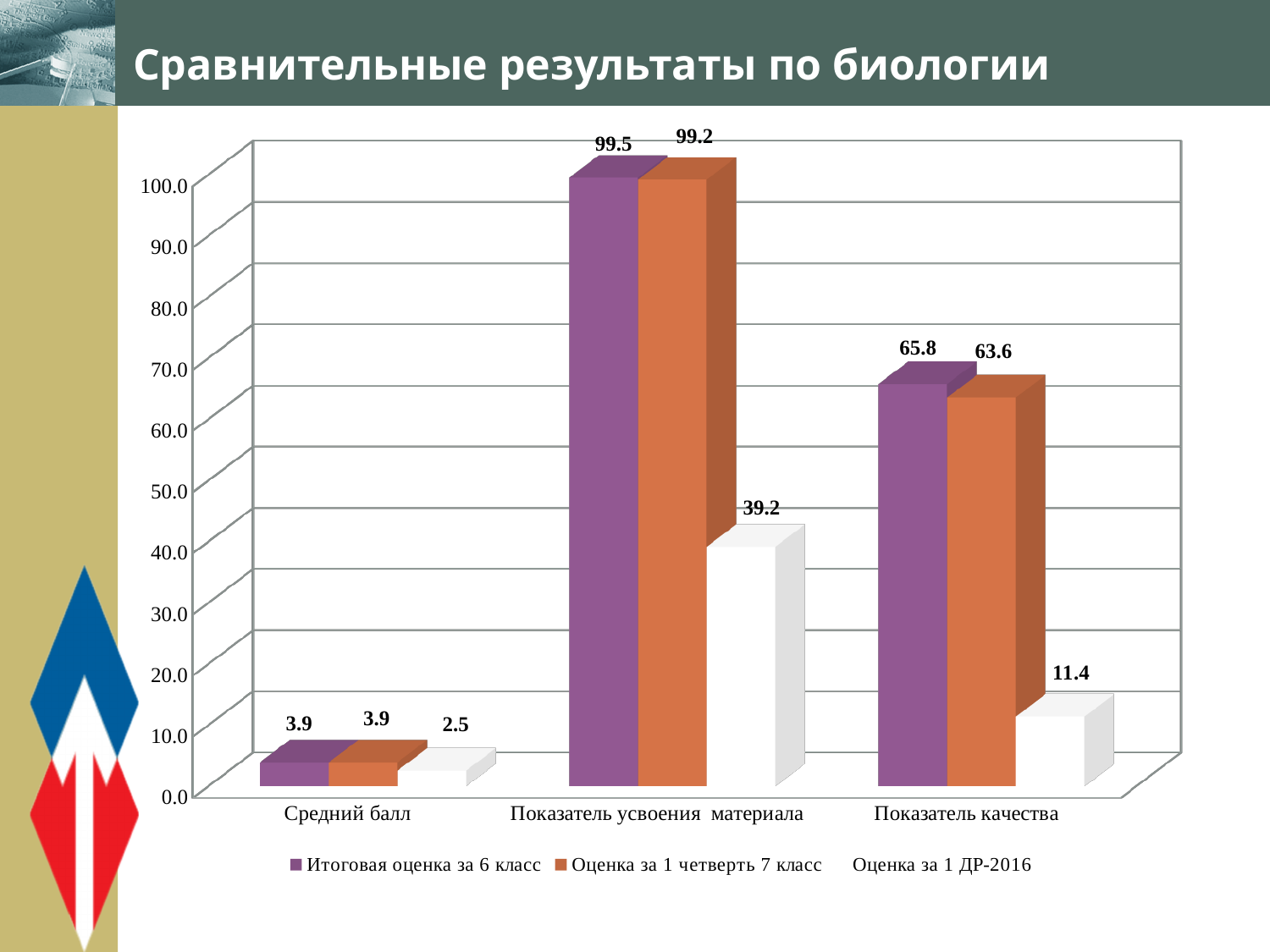
How many categories are shown on the x axis? 3 What type of chart is shown on the slide? Bar chart Is the value of "Оценка за 1 ДР-2016" for "Показатель усвоения материала" greater or less than 50.0? less Which category has the lowest value for "Оценка за 1 ДР-2016"? Средний балл What is the value of "Оценка за 1 четверть 7 класс" for "Средний балл"? 3.9 What is the difference between "Итоговая оценка за 6 класс" and "Оценка за 1 ДР-2016" for "Показатель качества"? 54.4 For "Показатель усвоения материала", which is larger: "Оценка за 1 четверть 7 класс" or "Оценка за 1 ДР-2016"? Оценка за 1 четверть 7 класс What is the value of "Итоговая оценка за 6 класс" for "Показатель усвоения материала"? 99.5 What is the value of "Оценка за 1 ДР-2016" for "Показатель усвоения материала"? 39.2 Which category has the highest value for "Оценка за 1 четверть 7 класс"? Показатель усвоения материала What is the value of "Оценка за 1 ДР-2016" for "Показатель качества"? 11.4 How many series does the legend list? 3